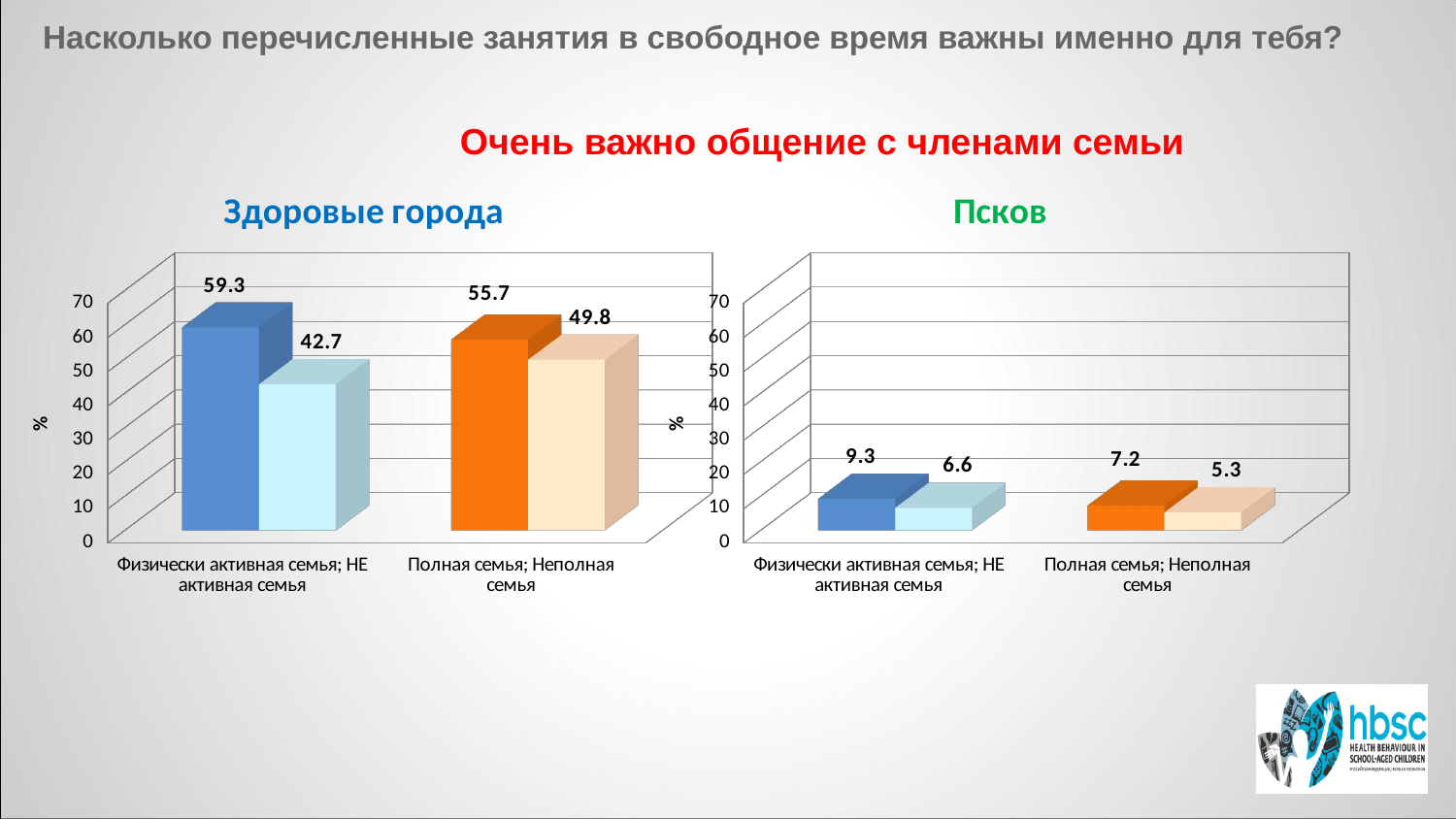
In the 'Здоровые города' chart, what is the value of the orange bar in the 'Полная семья; Неполная семья' group? 55.7 In the 'Здоровые города' chart, what is the difference between the two bars in the 'Физически активная семья; НЕ активная семья' group (59.3 and 42.7)? 16.6 In the 'Здоровые города' chart, what is the value of the dark blue bar in the 'Физически активная семья; НЕ активная семья' group? 59.3 In the 'Псков' chart, which bar has the highest value? The dark blue bar in the 'Физически активная семья; НЕ активная семья' group (9.3) How many category groups are shown on the x axis of the 'Псков' chart? 2 In the 'Псков' chart, is the value of the dark blue bar greater or less than 10? less In the 'Здоровые города' chart, which bar has the lowest value? The light blue bar in the 'Физически активная семья; НЕ активная семья' group (42.7) What type of chart is the 'Здоровые города' chart? bar chart In the 'Здоровые города' chart, what is the value of the light blue bar in the 'Физически активная семья; НЕ активная семья' group? 42.7 In the 'Псков' chart, what is the difference between the dark blue bar (9.3) and the light blue bar (6.6)? 2.7 In the 'Псков' chart, what is the value of the light orange bar in the 'Полная семья; Неполная семья' group? 5.3 In the 'Здоровые города' chart, which is larger: the orange bar (55.7) or the light orange bar (49.8)? The orange bar (55.7)